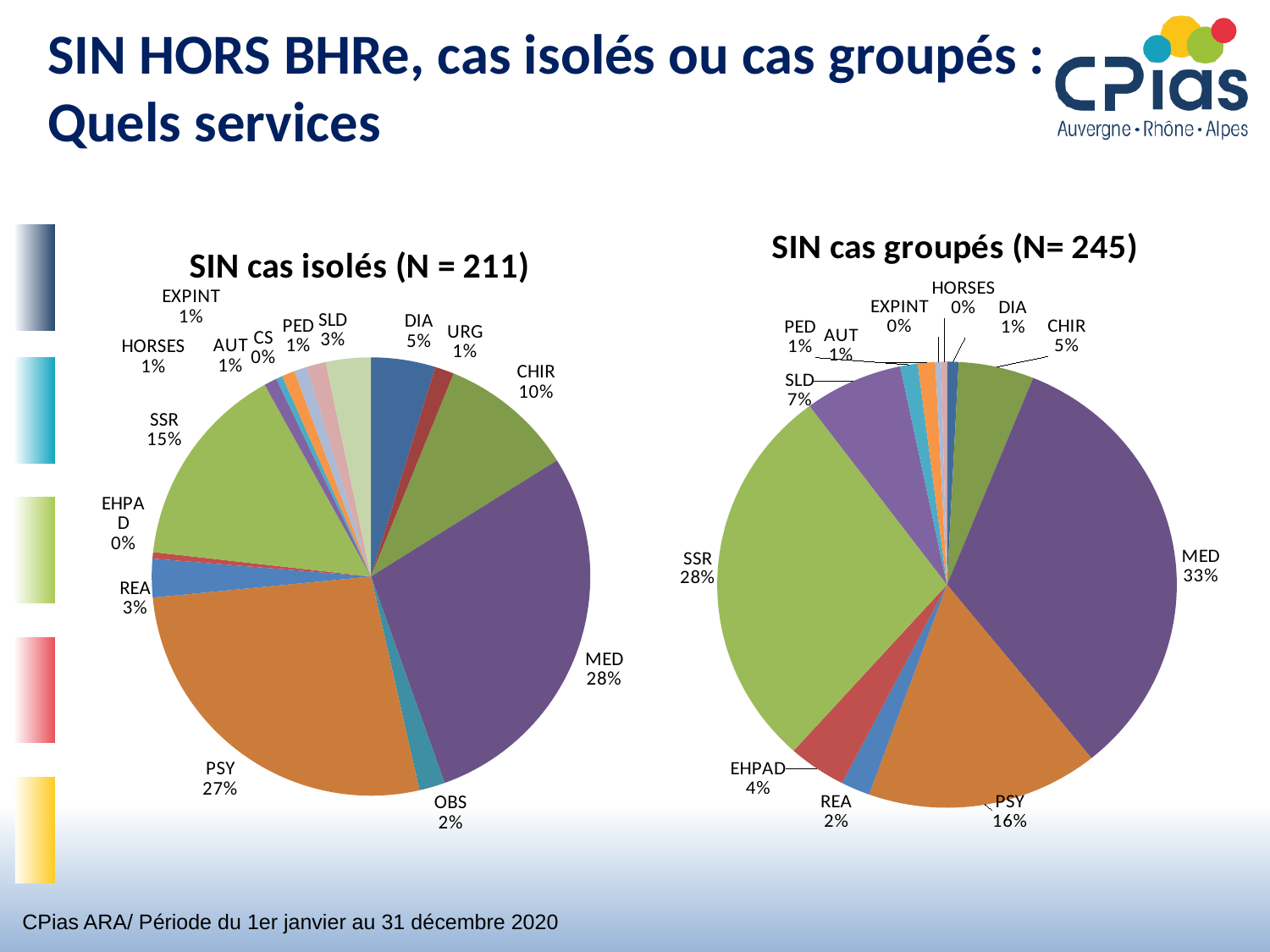
In the 'SIN cas isolés (N = 211)' chart, what share does SSR have? 15% What is the title of the pie chart on the right of the slide? SIN cas groupés (N= 245) What type of chart is used for 'SIN cas isolés (N = 211)'? pie chart In the 'SIN cas groupés (N= 245)' chart, which is larger, SSR or PSY? SSR In the 'SIN cas isolés (N = 211)' chart, what share does MED have? 28% In the 'SIN cas groupés (N= 245)' chart, what share does MED have? 33% How many services are labelled in the 'SIN cas groupés (N= 245)' chart? 12 How many services are labelled in the 'SIN cas isolés (N = 211)' chart? 15 In the 'SIN cas groupés (N= 245)' chart, what share does SLD have? 7% In the 'SIN cas isolés (N = 211)' chart, what is the difference between the MED and PSY shares? 1% In the 'SIN cas groupés (N= 245)' chart, what is the difference between the SSR and PSY shares? 12% In the 'SIN cas isolés (N = 211)' chart, which service has the largest share? MED